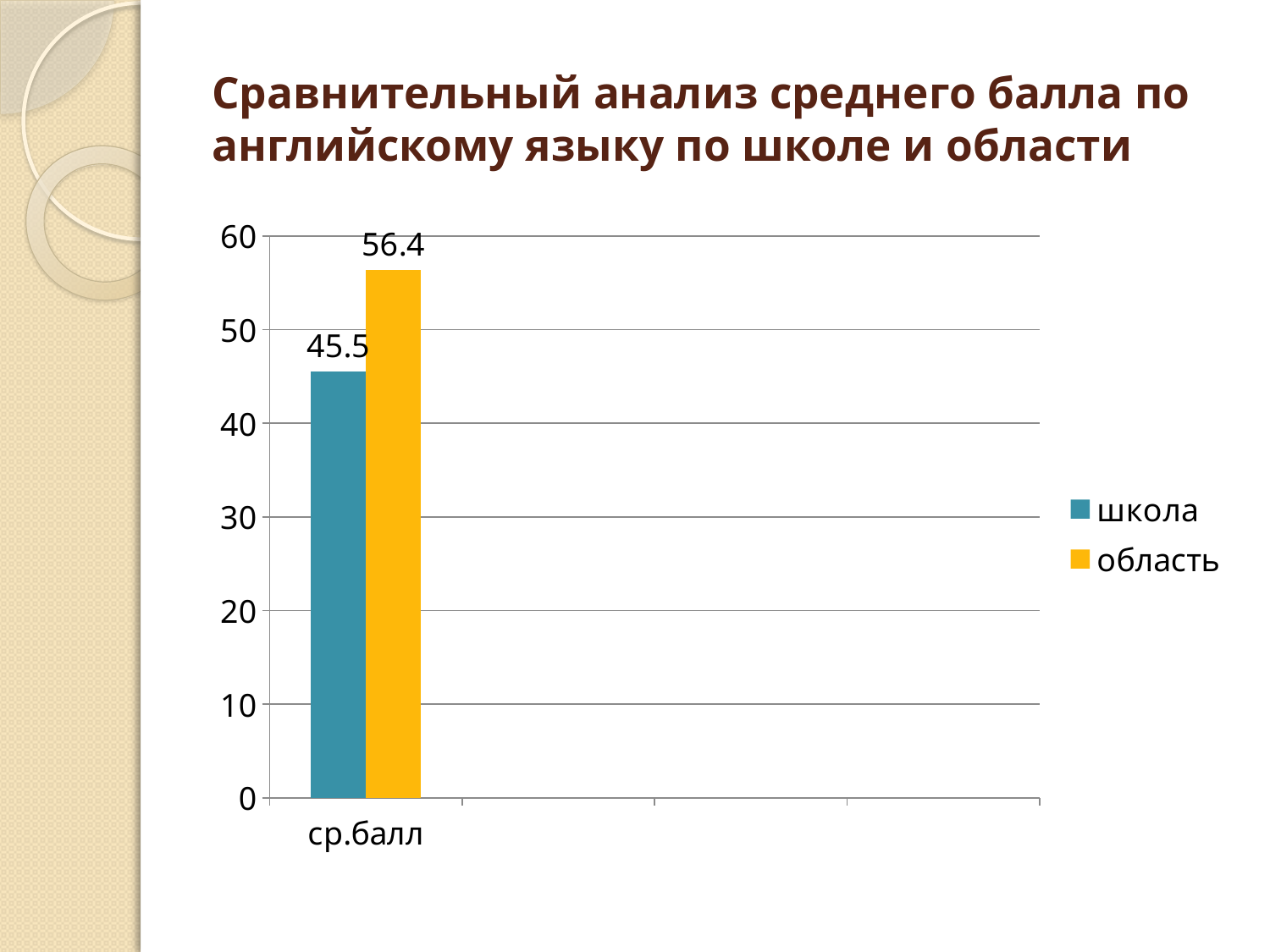
Which series has the higher value: школа or область? область Which series has the lowest value on the chart? школа What is the label of the category on the x axis? ср.балл What is the value for школа in the ср.балл category? 45.5 How many categories are shown on the x axis? 1 What is the value for область in the ср.балл category? 56.4 Which colour represents the область series? yellow Is the value for школа greater or less than 50? less What is the difference between the область value and the школа value? 10.9 What kind of chart is shown on the slide? bar chart How many series does the legend list? 2 Is the value for область greater or less than 50? greater